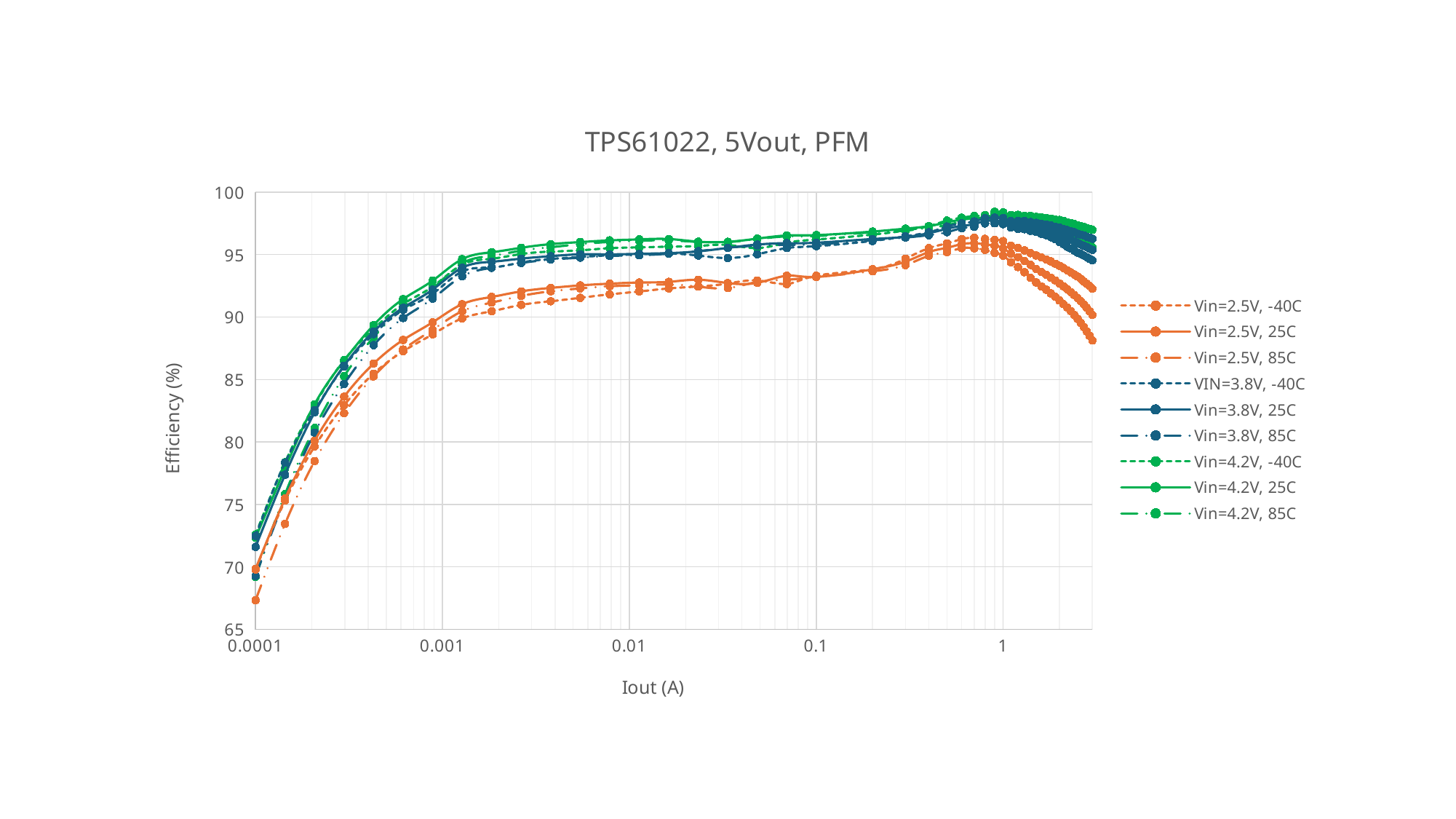
At Iout=0.01 A, which series has the higher efficiency: Vin=4.2V, 25C or Vin=2.5V, 25C? Vin=4.2V, 25C Is the efficiency for Vin=2.5V, 25C at Iout=0.01 A greater or less than 90? greater What is the title of the chart? TPS61022, 5Vout, PFM Is the efficiency for Vin=4.2V, 25C at Iout=0.01 A greater or less than 95? greater Is the efficiency for Vin=4.2V, 25C at Iout=0.0001 A greater or less than 70? greater Does the efficiency for Vin=2.5V, 25C rise or fall as Iout increases from 0.0001 A to 0.001 A? rise What is the label of the y axis? Efficiency (%) How many series does the legend list? 9 What kind of chart is shown on the slide? line chart Does the efficiency for Vin=4.2V, 25C rise or fall as Iout increases from 1 A to 3 A? fall